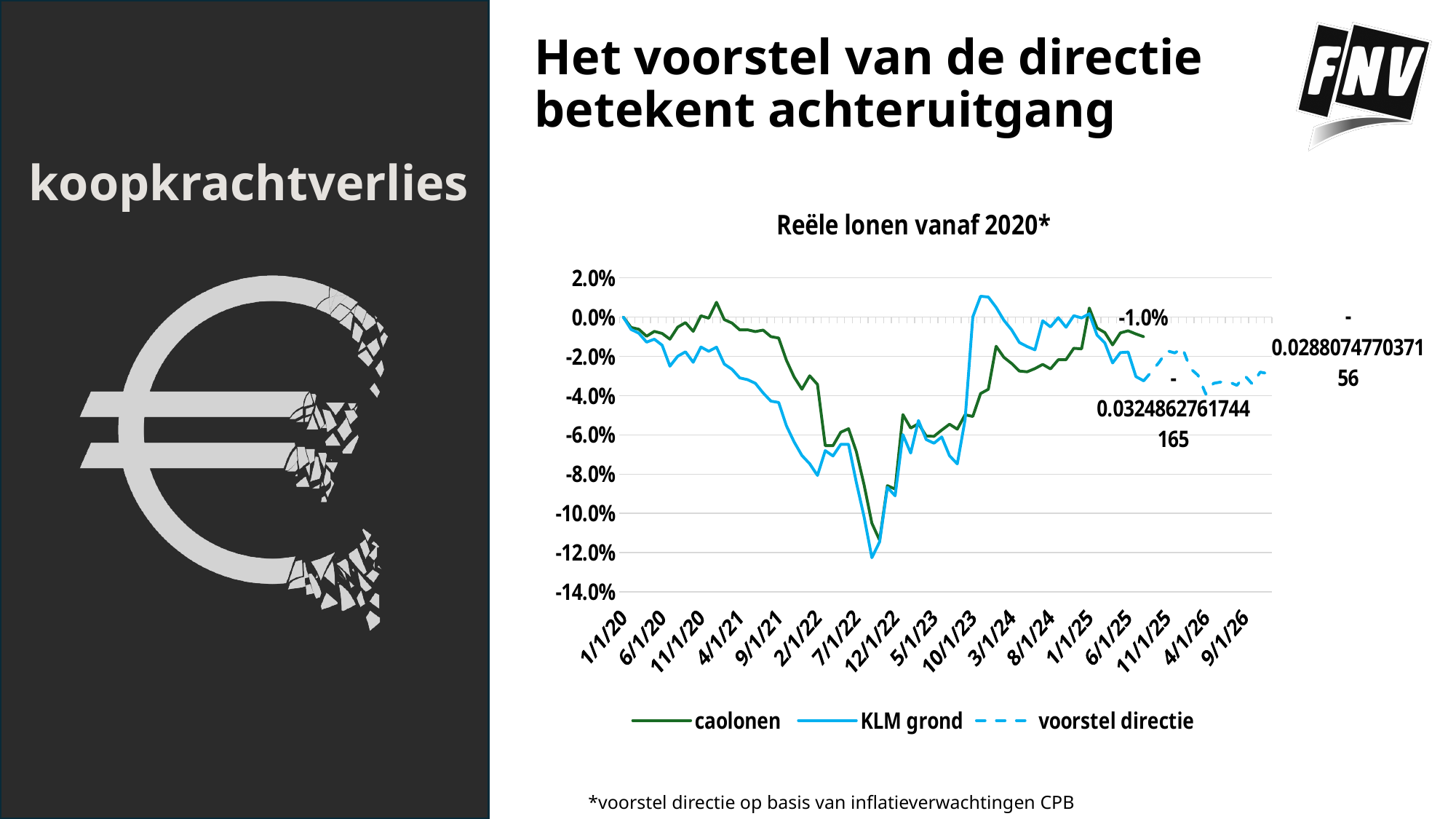
What kind of chart is shown on the slide? line chart Around 12/1/22, which line is lower: caolonen or KLM grond? KLM grond Which series is drawn with a dashed line? voorstel directie What is the data label shown at the end of the voorstel directie line? -0.028807477037156 What is the data label shown at the end of the KLM grond line? -0.0324862761744165 Is the lowest value of the KLM grond line greater or less than -10.0%? less Is the highest value of the caolonen line greater or less than 0.0%? greater How many series does the chart legend list? 3 Does the caolonen line rise or fall between 1/1/20 and 12/1/22? fall What is the title of the chart? Reële lonen vanaf 2020* What is the data label shown at the end of the caolonen line? -1.0%